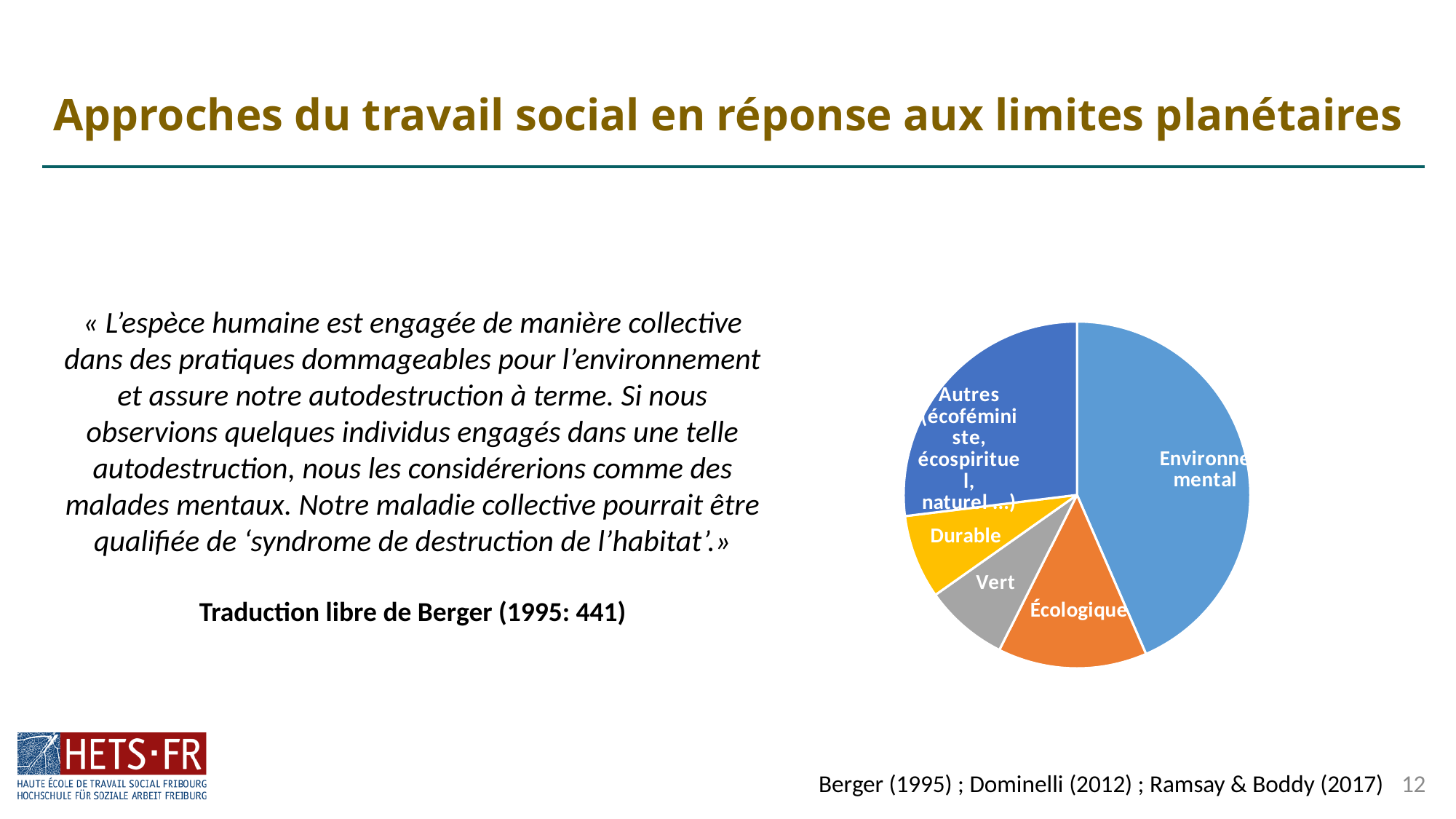
What colour is the Écologique slice of the pie chart? orange Which slice is larger, Environnemental or Durable? Environnemental What kind of chart is shown on the slide? pie chart Which category has the second-largest slice of the pie chart? Autres (écoféministe, écospirituel, naturel ...) What colour is the Durable slice of the pie chart? yellow Which slice is larger, Autres (écoféministe, écospirituel, naturel ...) or Écologique? Autres (écoféministe, écospirituel, naturel ...) Which slice is larger, Écologique or Vert? Écologique How many slices does the pie chart have? 5 Which category has the largest slice of the pie chart? Environnemental